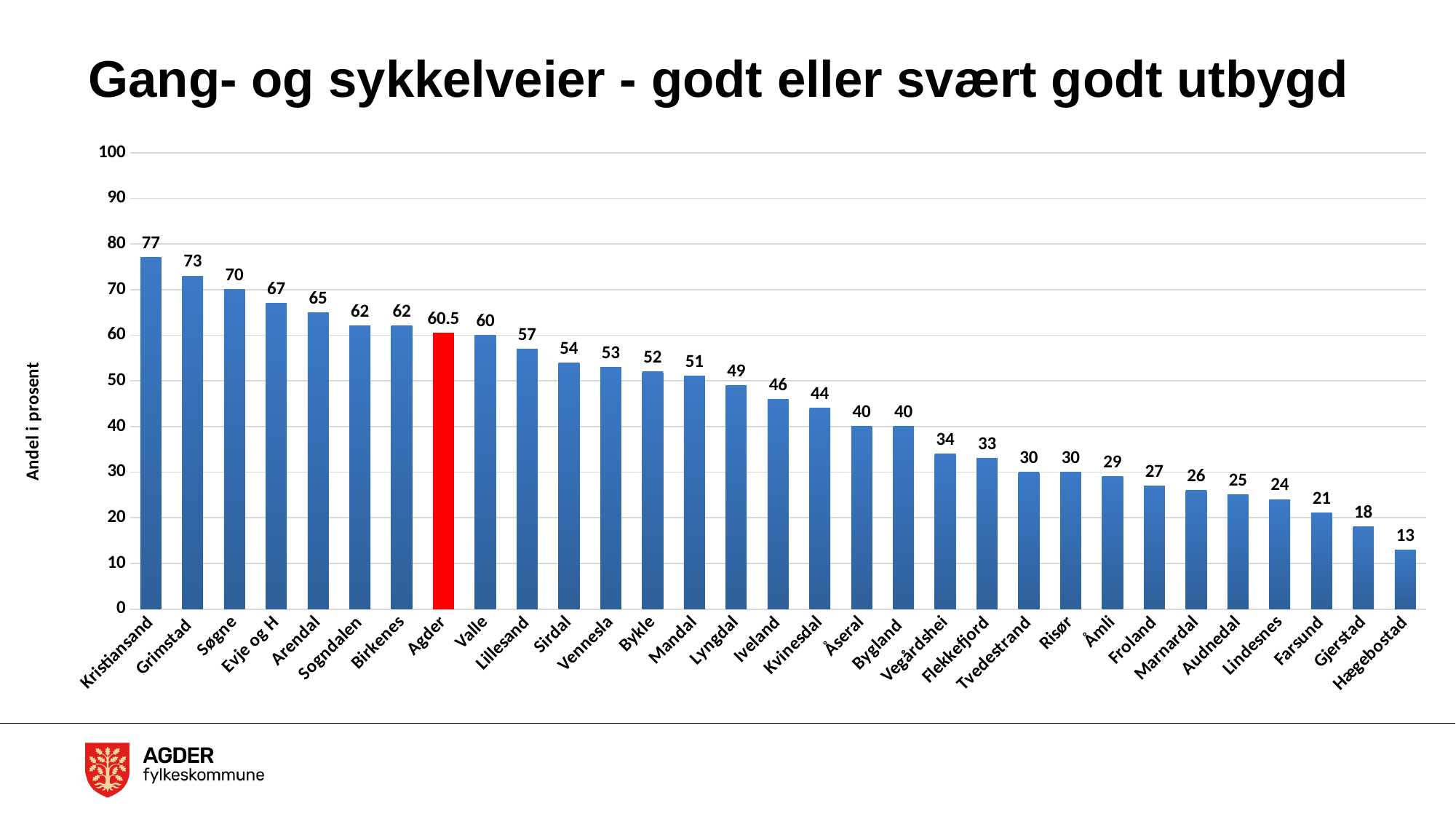
What is the difference between the values for Grimstad and Farsund? 52 Is the value for Vegårdshei greater or less than 40? less Which category has the lowest value? Hægebostad What is the value for Agder, the red bar? 60.5 Which category has the highest value? Kristiansand Do the values rise or fall from left to right along the x axis? fall What is the value for Kristiansand? 77 Which is larger, the value for Lillesand or the value for Mandal? Lillesand What is the label of the y axis? Andel i prosent What kind of chart is shown on the slide? bar chart What is the value for Hægebostad? 13 How many categories are shown on the x axis? 31